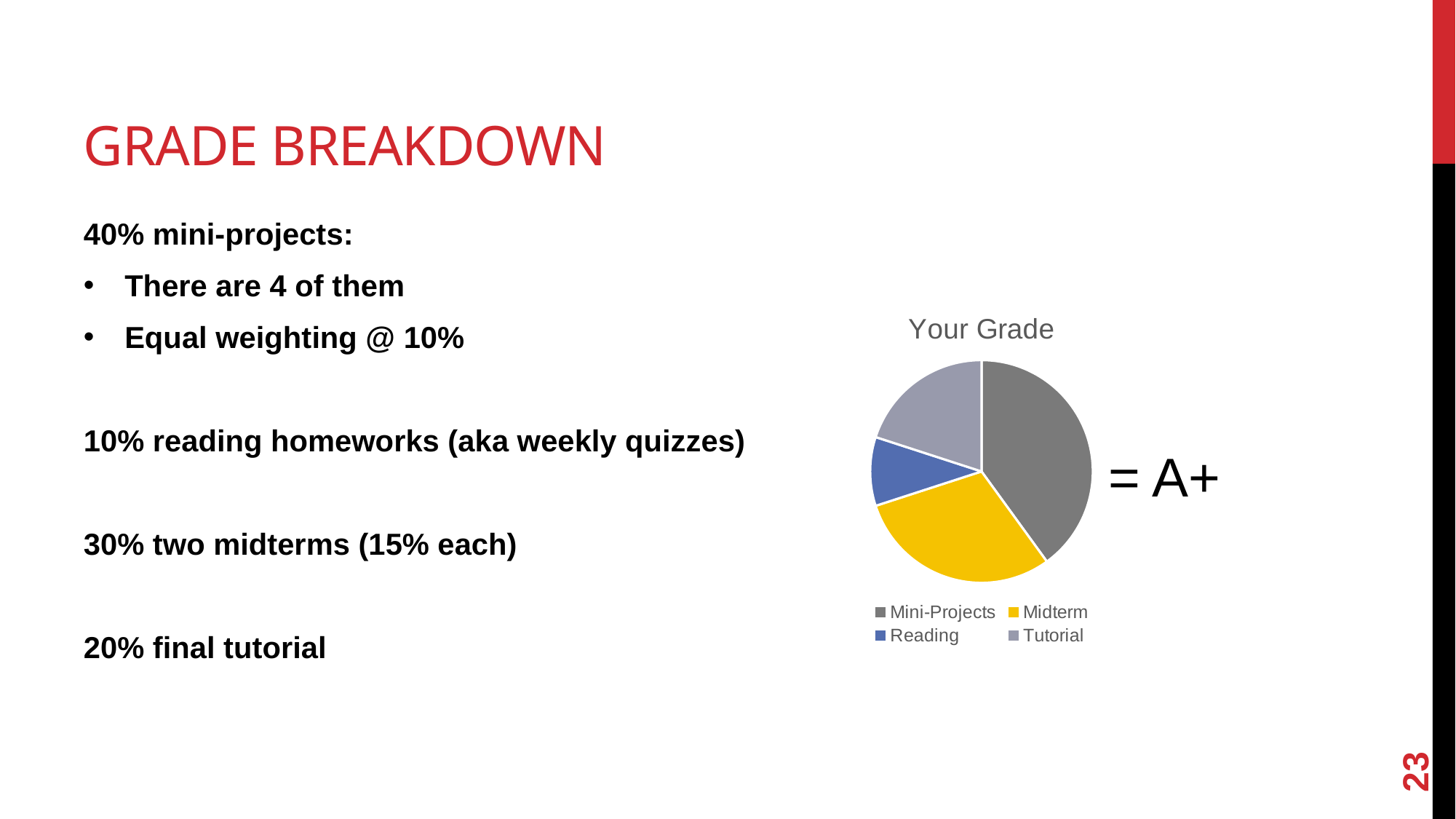
How many entries does the chart legend list? 4 Which slice is larger, Mini-Projects or Midterm? Mini-Projects Which category has the largest slice of the pie? Mini-Projects Which slice is larger, Tutorial or Reading? Tutorial What is the title of the chart? Your Grade Which category is shown in yellow in the pie chart? Midterm Which category has the smallest slice of the pie? Reading What kind of chart is shown on the slide? pie chart How many slices does the pie chart have? 4 Which slice is larger, Midterm or Tutorial? Midterm